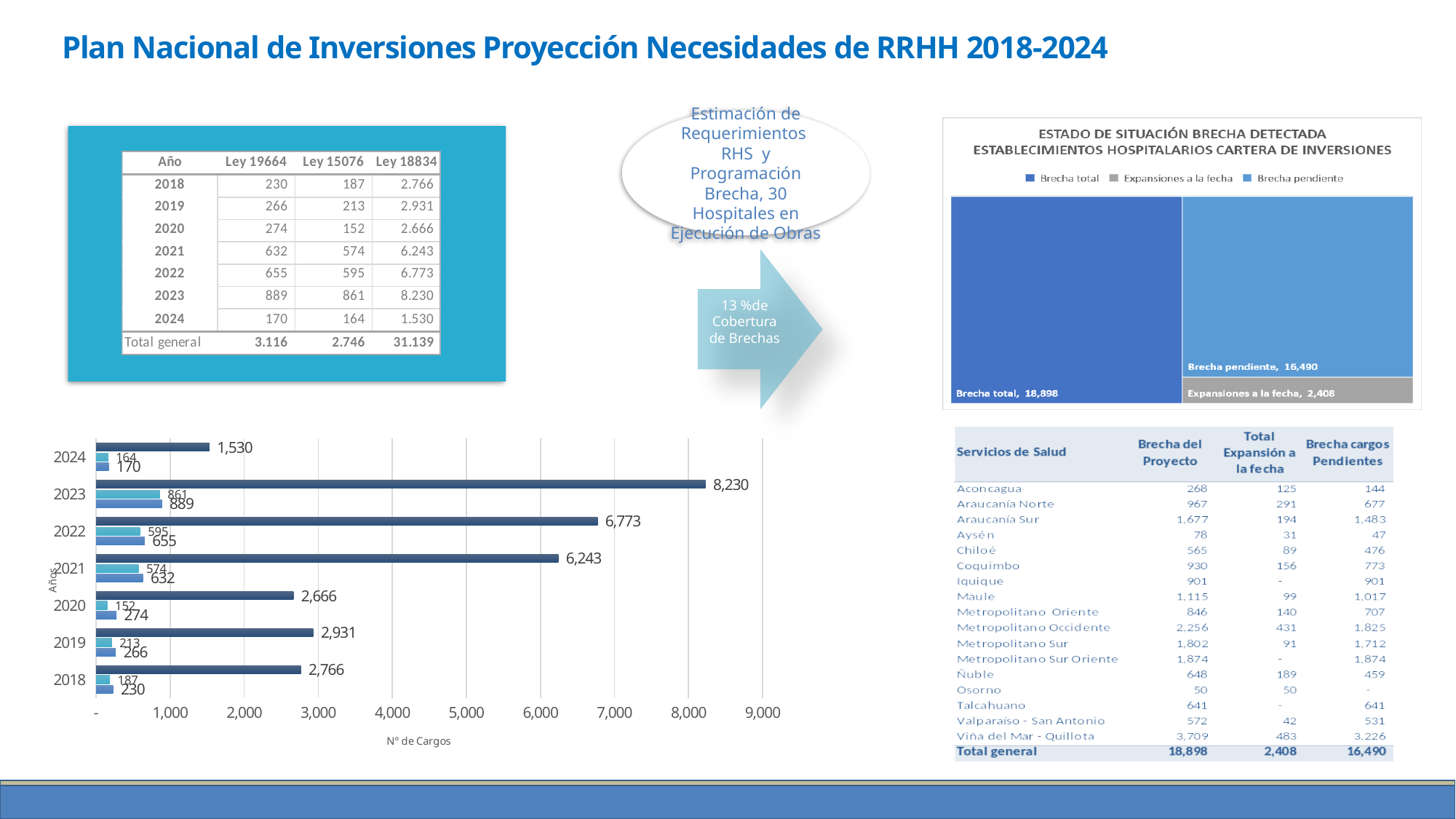
In the chart titled 'ESTADO DE SITUACIÓN BRECHA DETECTADA', what is the value for Brecha pendiente? 16,490 In the bottom-left bar chart, what is the value of the longest bar for 2023? 8,230 In the chart titled 'ESTADO DE SITUACIÓN BRECHA DETECTADA', what is the value for Brecha total? 18,898 In the bottom-left bar chart, how many years are shown on the vertical axis? 7 In the bottom-left bar chart, which year has the longest bar overall? 2023 In the bottom-left bar chart, what is the value of the longest bar for 2024? 1,530 In the chart titled 'ESTADO DE SITUACIÓN BRECHA DETECTADA', how many entries does the legend list? 3 In the bottom-left bar chart, is the longest bar for 2021 greater or less than 6,000? greater In the bottom-left bar chart, what is the title of the horizontal axis? N° de Cargos In the bottom-left bar chart, which year has the longer top bar, 2019 or 2020? 2019 What kind of chart is the chart at the bottom left of the slide? bar chart In the bottom-left bar chart, what is the difference between the longest bars for 2023 and 2022? 1,457